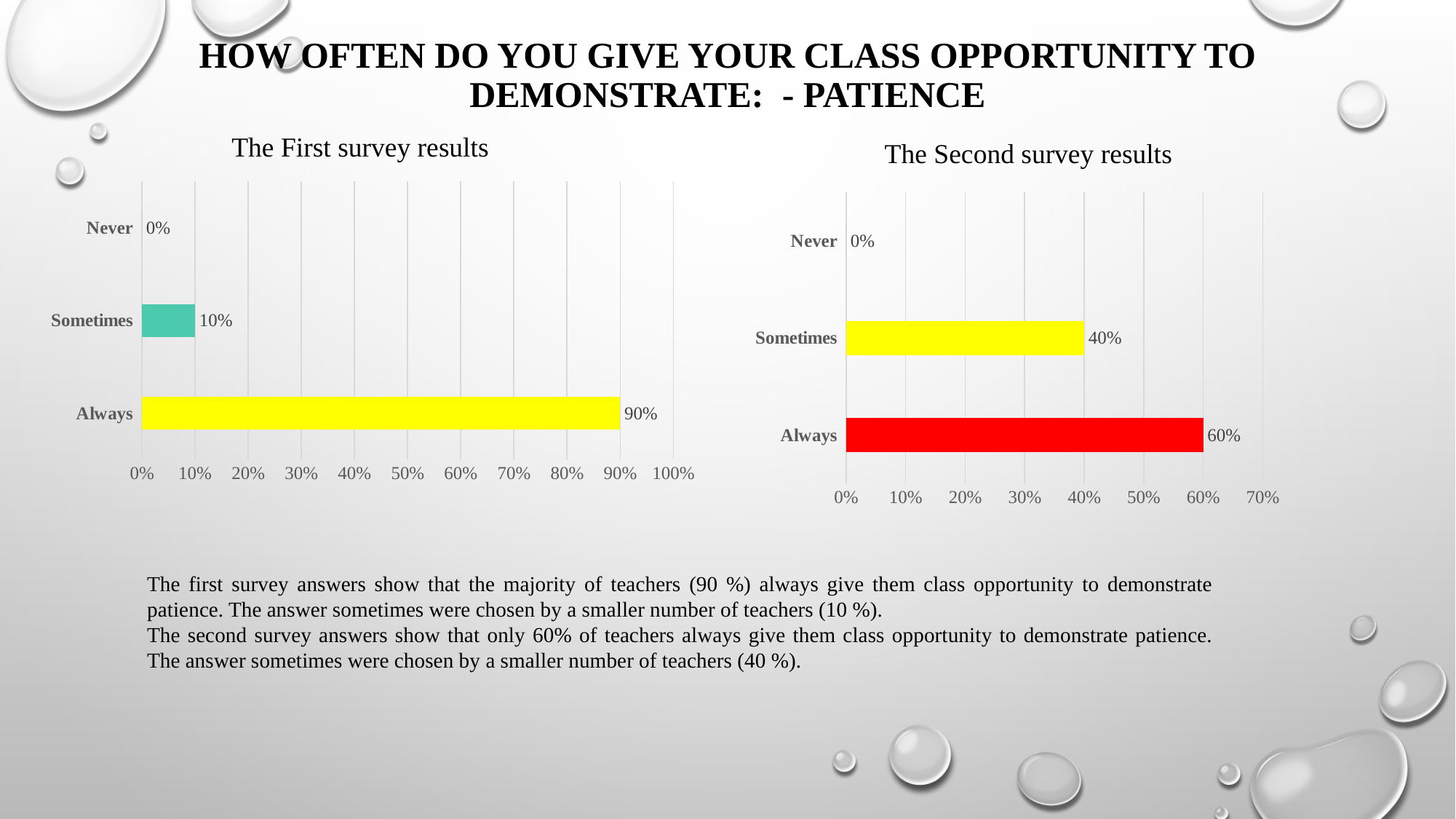
In the chart titled "The First survey results", what is the value for Always? 90% In the chart titled "The Second survey results", what is the value for Sometimes? 40% In the chart titled "The First survey results", what is the difference between the values for Always and Sometimes? 80% In the chart titled "The Second survey results", which category has the lowest value? Never What type of chart is "The First survey results"? Bar chart In the chart titled "The Second survey results", what is the difference between the values for Always and Sometimes? 20% In the chart titled "The First survey results", which category has the highest value? Always Which is larger: the value for Always in the first survey chart or the value for Always in the second survey chart? The First survey results In the chart titled "The Second survey results", what is the value for Never? 0% In the chart titled "The Second survey results", what is the value for Always? 60% How many categories are shown in the chart titled "The Second survey results"? 3 In the chart titled "The First survey results", what is the value for Sometimes? 10%